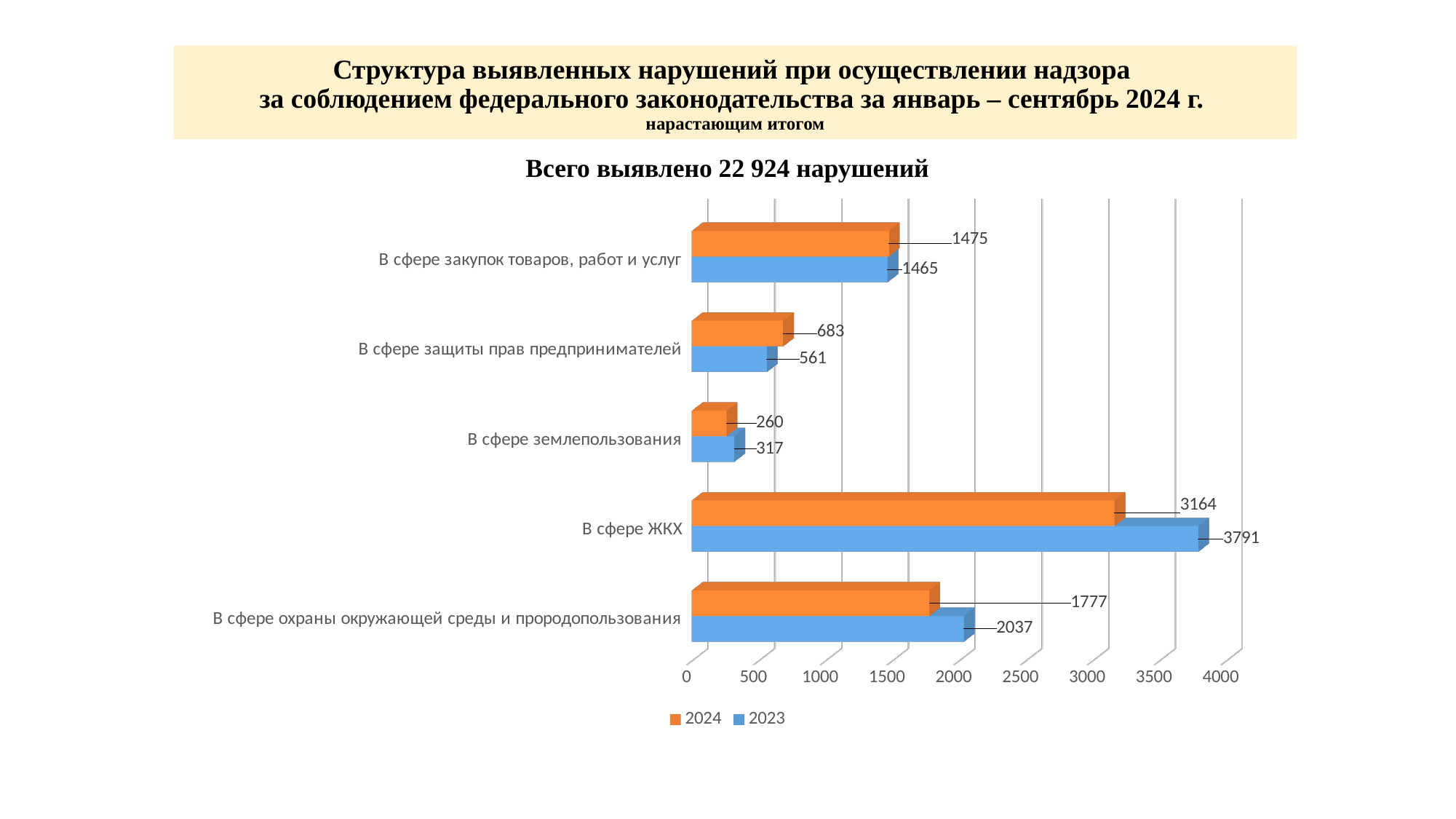
What is the title of the chart? Всего выявлено 22 924 нарушений What is the difference between the 2024 and 2023 values for «В сфере защиты прав предпринимателей»? 122 What is the 2024 value for «В сфере ЖКХ»? 3164 Which category has the lowest 2024 value? В сфере землепользования How many series does the legend list? 2 What is the 2023 value for «В сфере землепользования»? 317 What is the difference between the 2023 and 2024 values for «В сфере ЖКХ»? 627 What kind of chart is shown on the slide? Bar chart How many categories are shown on the chart? 5 Which category has the highest 2023 value? В сфере ЖКХ What is the 2024 value for «В сфере защиты прав предпринимателей»? 683 For «В сфере охраны окружающей среды и природопользования», which year has the larger value, 2024 or 2023? 2023